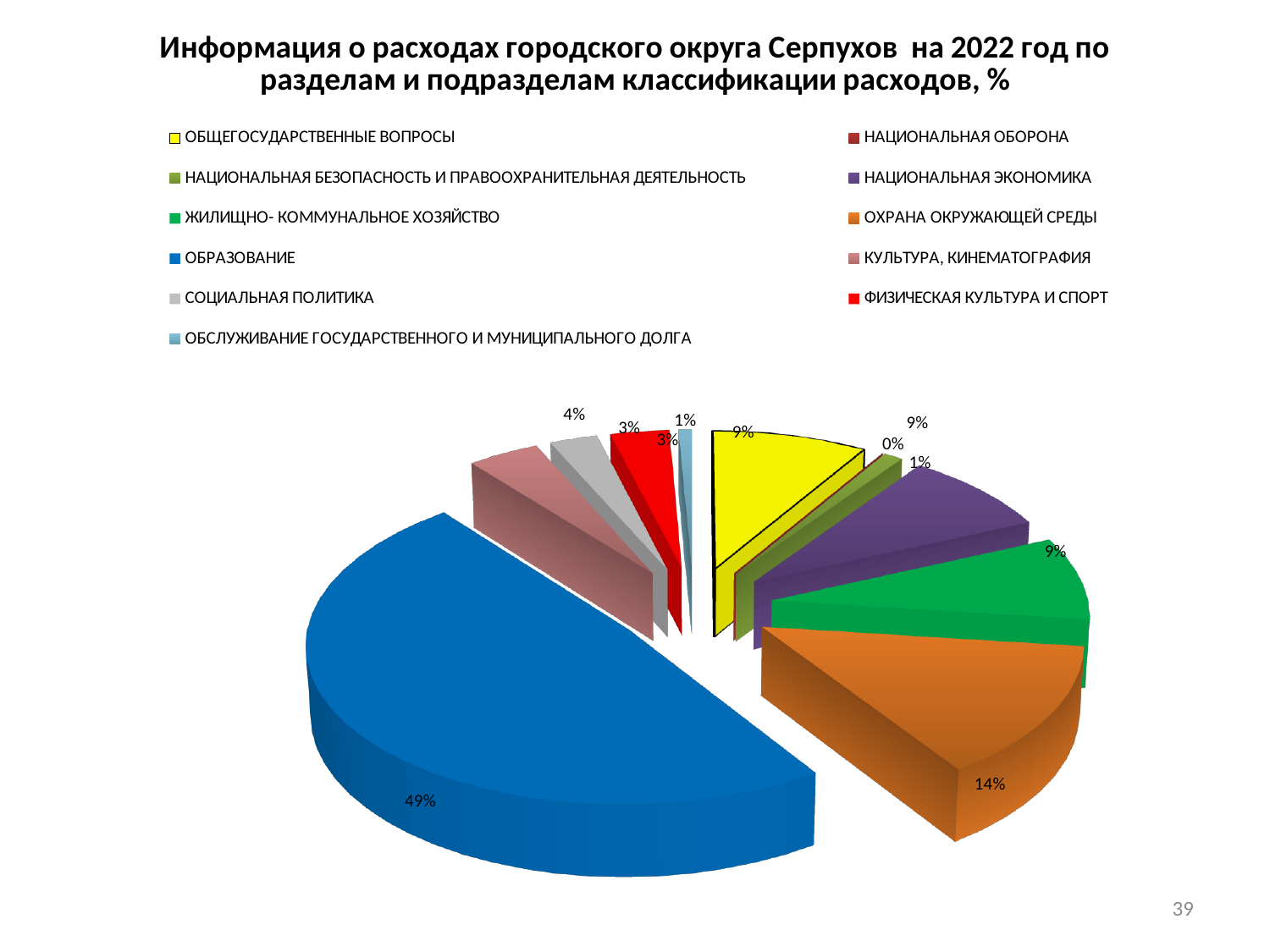
What share of expenditures goes to ОХРАНА ОКРУЖАЮЩЕЙ СРЕДЫ? 14% What kind of chart is shown on the slide? pie chart What share of expenditures goes to СОЦИАЛЬНАЯ ПОЛИТИКА? 3% Which is larger, the share for ОБРАЗОВАНИЕ or for ОХРАНА ОКРУЖАЮЩЕЙ СРЕДЫ? ОБРАЗОВАНИЕ What share of expenditures goes to ОБРАЗОВАНИЕ? 49% What colour is the slice for ОБРАЗОВАНИЕ? blue How many categories does the legend list? 11 What share of expenditures goes to ЖИЛИЩНО- КОММУНАЛЬНОЕ ХОЗЯЙСТВО? 9% What share of expenditures goes to КУЛЬТУРА, КИНЕМАТОГРАФИЯ? 4% By how many percentage points does the share for ОБРАЗОВАНИЕ exceed the share for ОХРАНА ОКРУЖАЮЩЕЙ СРЕДЫ? 35 What share of expenditures goes to ОБЩЕГОСУДАРСТВЕННЫЕ ВОПРОСЫ? 9% Which category has the largest share of expenditures? ОБРАЗОВАНИЕ